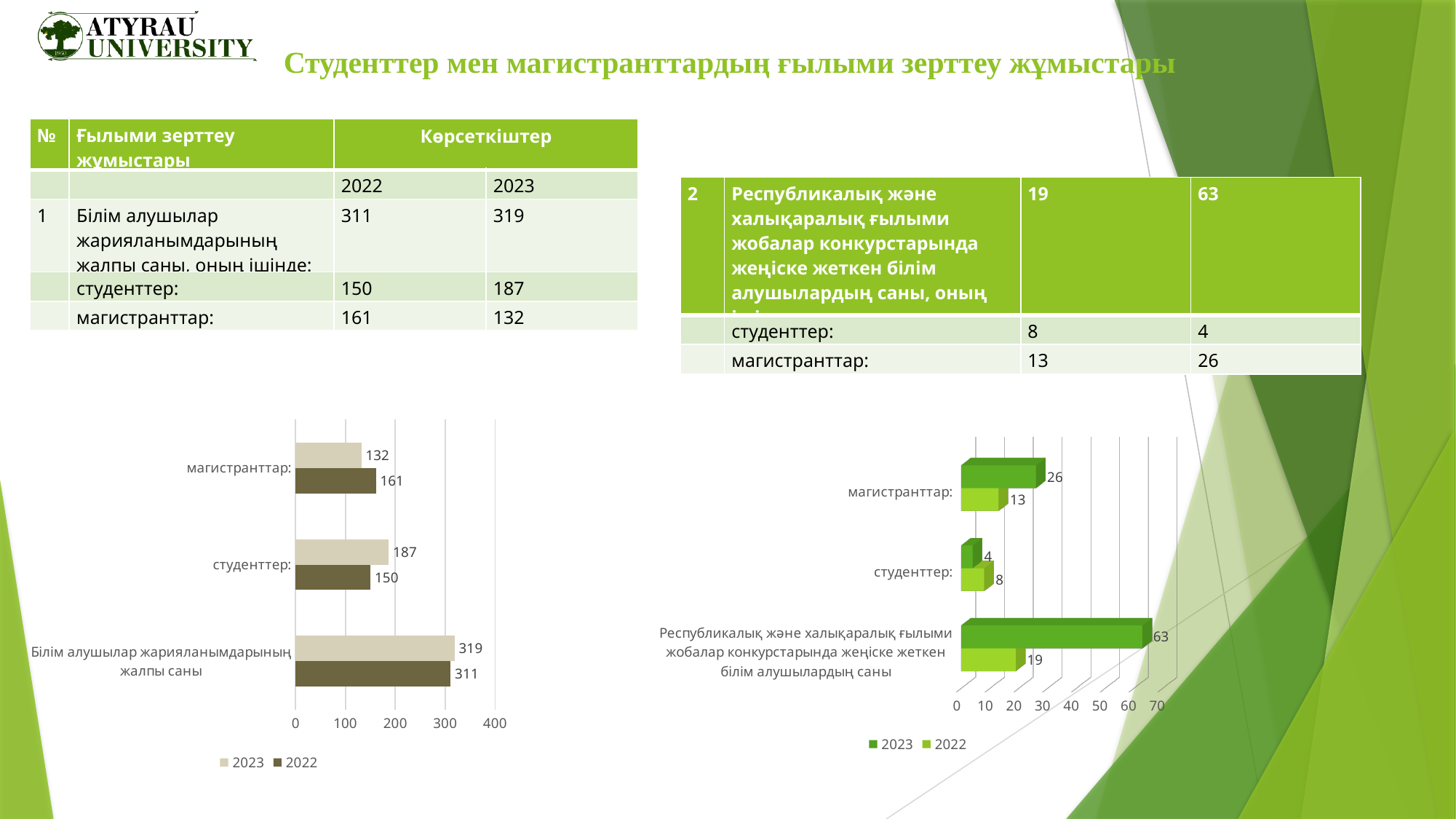
In the right chart, what is the 2022 value for студенттер? 8 What kind of chart is the left chart? Bar chart In the left chart, what is the difference between the 2023 and 2022 values for Білім алушылар жарияланымдарының жалпы саны? 8 In the right chart, which category has the lowest 2023 value? студенттер In the right chart, which category has the highest 2023 value? Республикалық және халықаралық ғылыми жобалар конкурстарында жеңіске жеткен білім алушылардың саны In the right chart, what is the difference between the 2023 and 2022 values for магистранттар? 13 In the left chart, what is the 2023 value for студенттер? 187 In the left chart, how many categories are shown on the vertical axis? 3 In the right chart, what is the 2023 value for магистранттар? 26 How many series does the legend of the right chart list? 2 In the left chart, what is the 2022 value for магистранттар? 161 In the left chart, which is larger for магистранттар: the 2022 value or the 2023 value? 2022